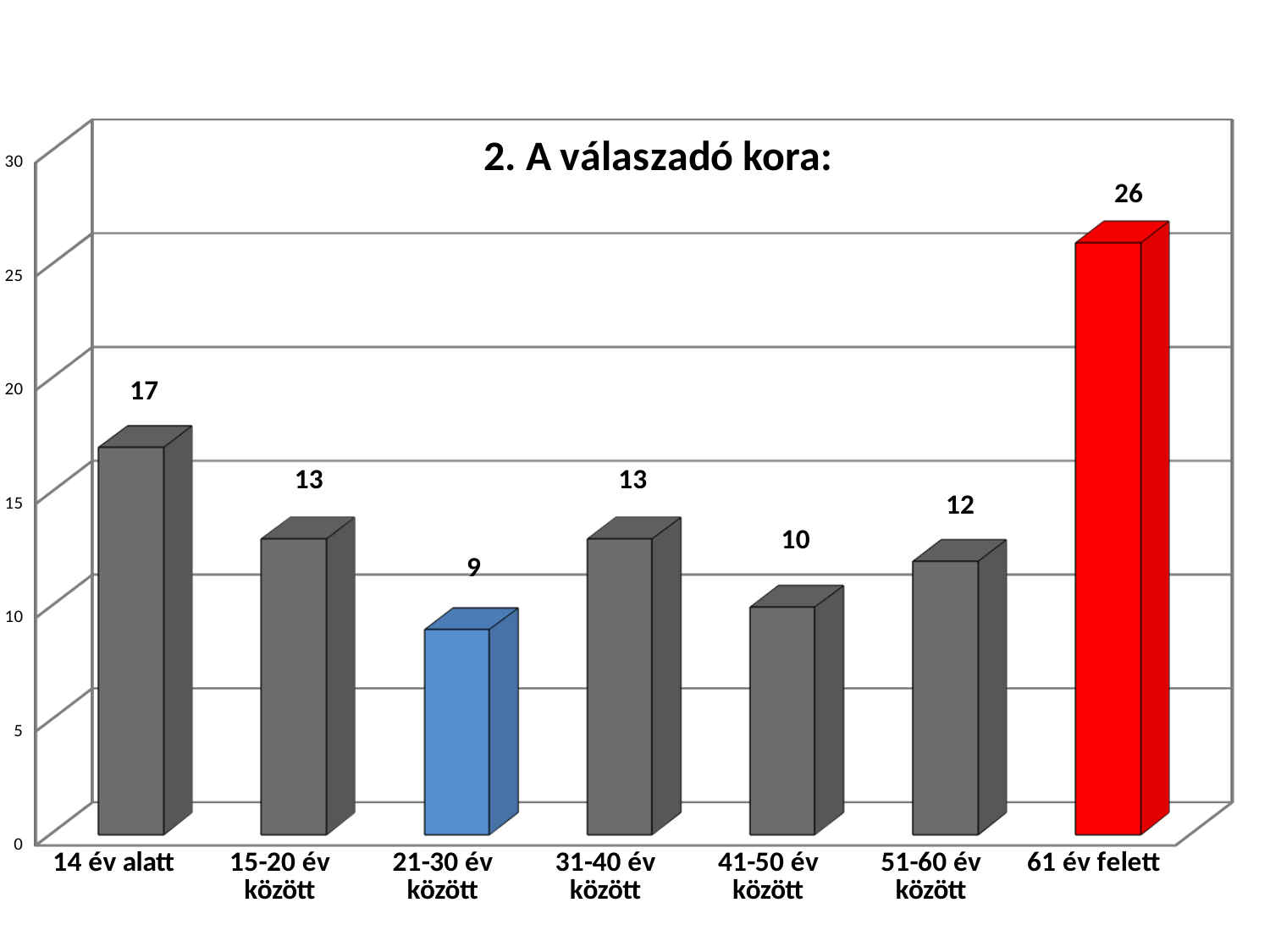
What is the value for "51-60 év között"? 12 What is the value for "61 év felett"? 26 What is the difference between the values for "61 év felett" and "14 év alatt"? 9 Which category has the lowest value? 21-30 év között How many categories are shown on the x axis? 7 What is the value for "14 év alatt"? 17 What kind of chart is shown on the slide? bar chart Is the value for "31-40 év között" greater or less than 15? less Which category has the highest value? 61 év felett Which is larger, the value for "41-50 év között" or the value for "51-60 év között"? 51-60 év között What is the title of the chart? 2. A válaszadó kora: What is the value for "21-30 év között"? 9